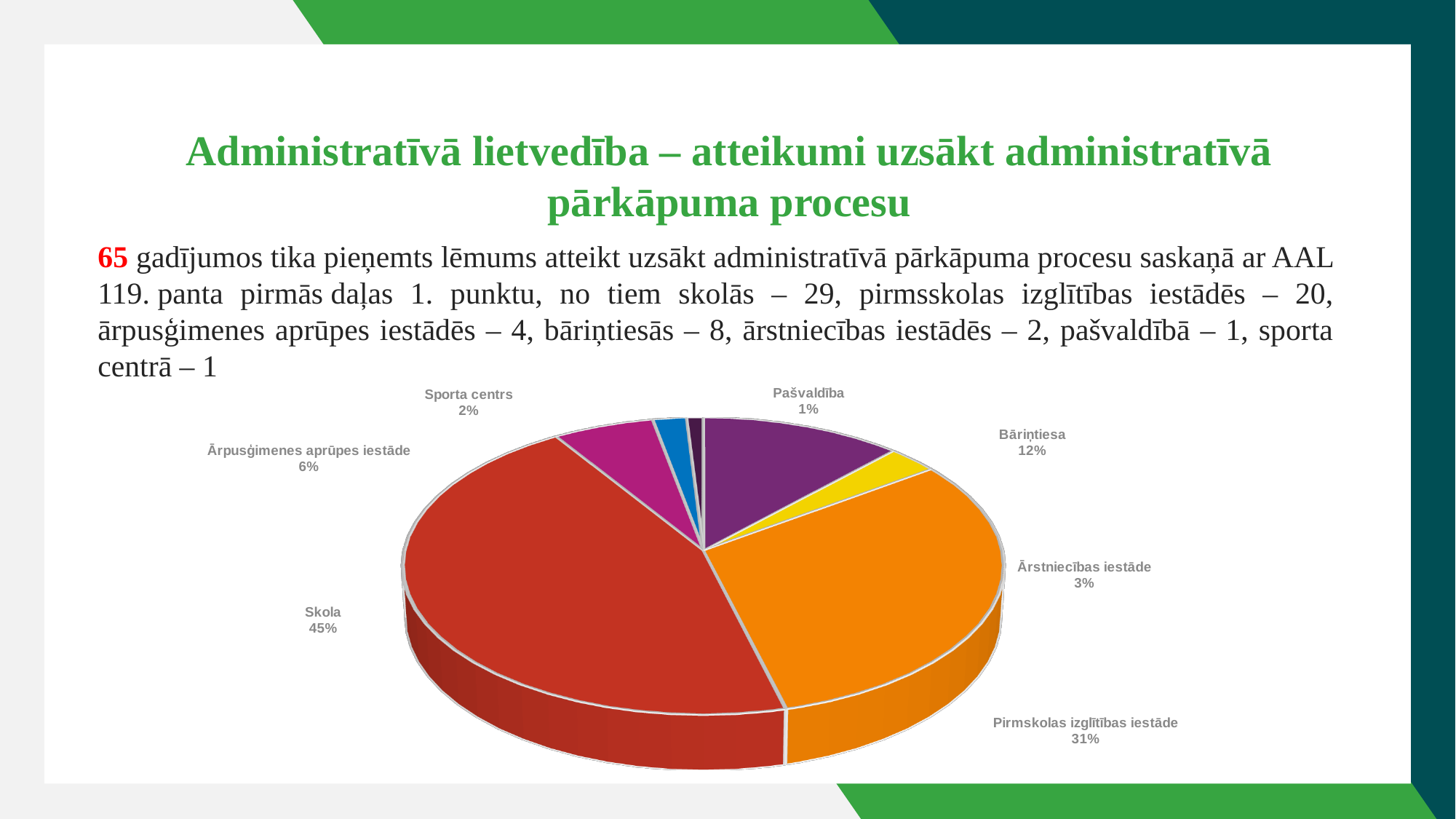
What percentage is shown for Pašvaldība? 1% Which category has the smallest slice of the pie? Pašvaldība Which is larger, the share for Bāriņtiesa or the share for Ārstniecības iestāde? Bāriņtiesa Which category has the largest slice of the pie? Skola What share of the pie does Skola represent? 45% What kind of chart is shown on the slide? Pie chart What colour is the Skola slice of the pie? Red What is the difference in percentage points between Skola and Pirmskolas izglītības iestāde? 14 What percentage is shown for Bāriņtiesa? 12% How many slices does the pie chart have? 7 What percentage is shown for Pirmskolas izglītības iestāde? 31% What percentage is shown for Ārpusģimenes aprūpes iestāde? 6%